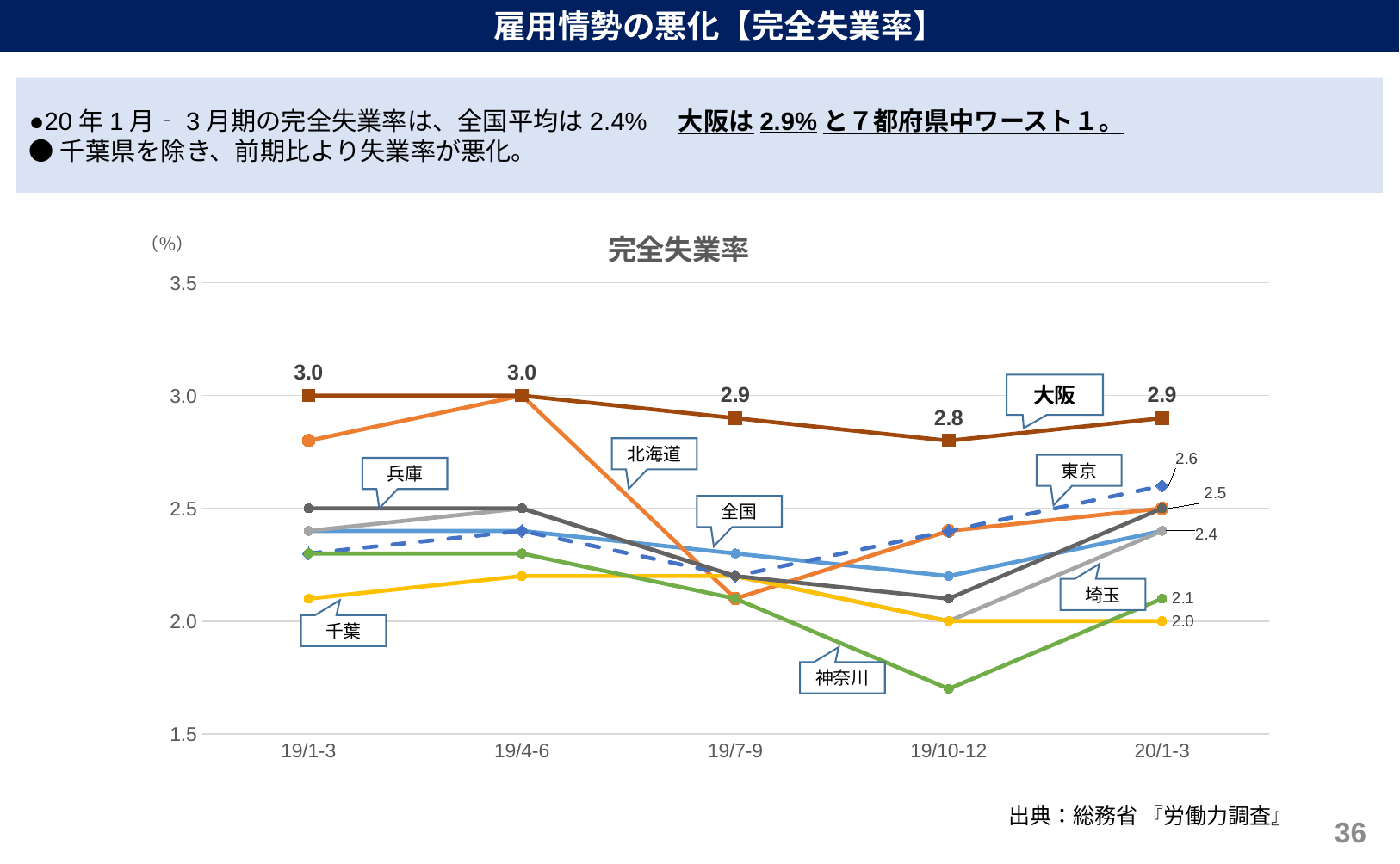
What is the value for 大阪 in 20/1-3? 2.9 How many periods are shown on the x axis? 5 What is the value for 大阪 in 19/10-12? 2.8 Is the value for 神奈川 in 19/10-12 greater or less than 2.0? less Does the value for 大阪 rise or fall from 19/4-6 to 19/10-12? fall What is the value for 千葉 in 20/1-3? 2.0 Which is larger in 20/1-3, the value for 大阪 or the value for 東京? 大阪 In which period is the value for 大阪 lowest? 19/10-12 What kind of chart is shown on the slide? line chart What is the title of the chart? 完全失業率 What is the difference between the 大阪 values in 19/4-6 and 19/10-12? 0.2 What is the value for 東京 in 20/1-3? 2.6